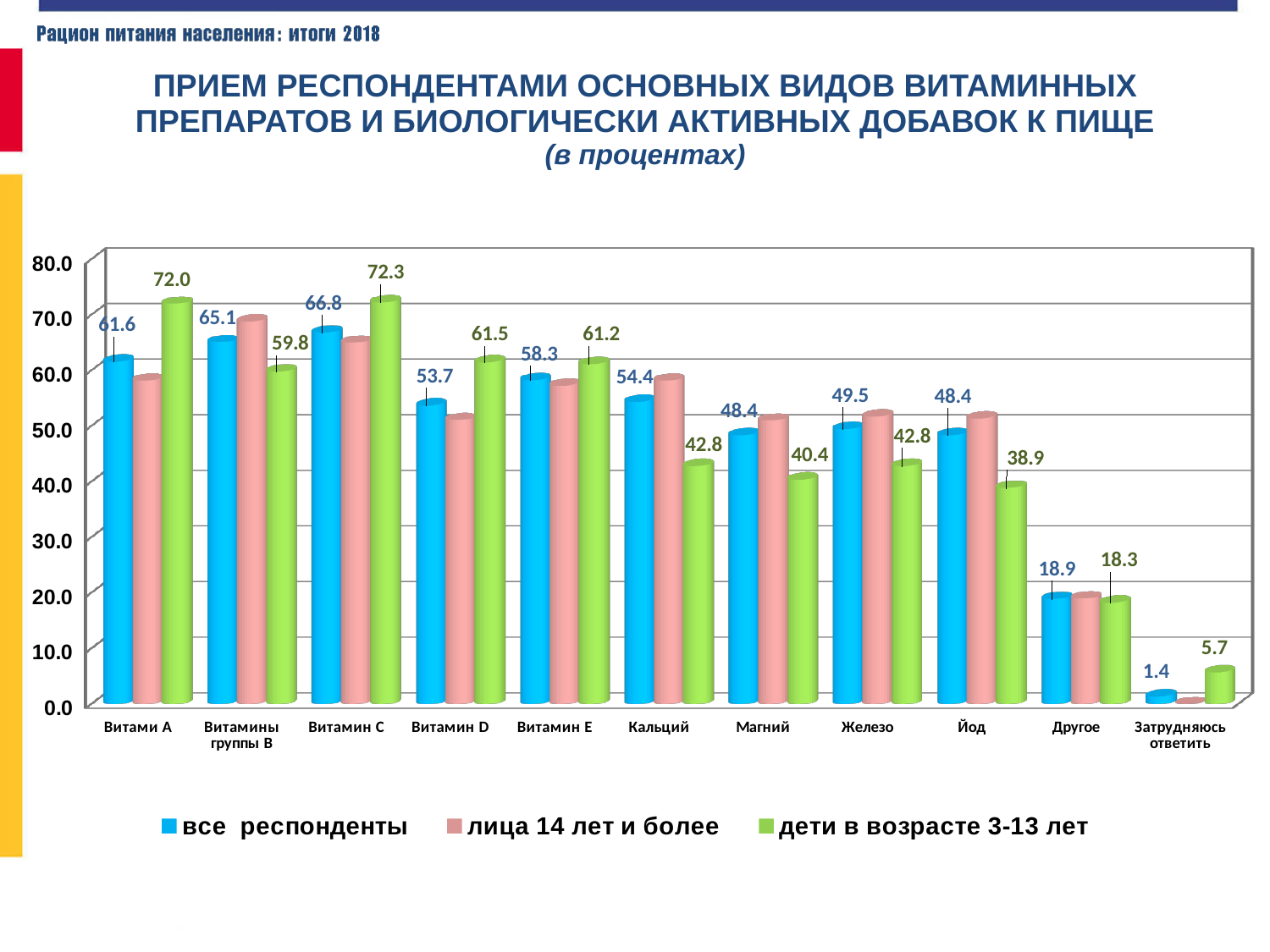
Is the value for "лица 14 лет и более" for Витамины группы В greater or less than 60.0? greater What is the value for "все респонденты" for Витамин C? 66.8 How many categories are shown on the x axis? 11 For Кальций, which is larger: the value for "все респонденты" or for "дети в возрасте 3-13 лет"? все респонденты Which category has the lowest value for "все респонденты"? Затрудняюсь ответить Is the value for "лица 14 лет и более" for Йод greater or less than 60.0? less Which category has the highest value for "дети в возрасте 3-13 лет"? Витамин C What is the value for "дети в возрасте 3-13 лет" for Витамин D? 61.5 What kind of chart is shown on the slide? bar chart How many series does the legend list? 3 What is the value for "все респонденты" for Затрудняюсь ответить? 1.4 What is the difference between the "дети в возрасте 3-13 лет" value and the "все респонденты" value for Витами А? 10.4